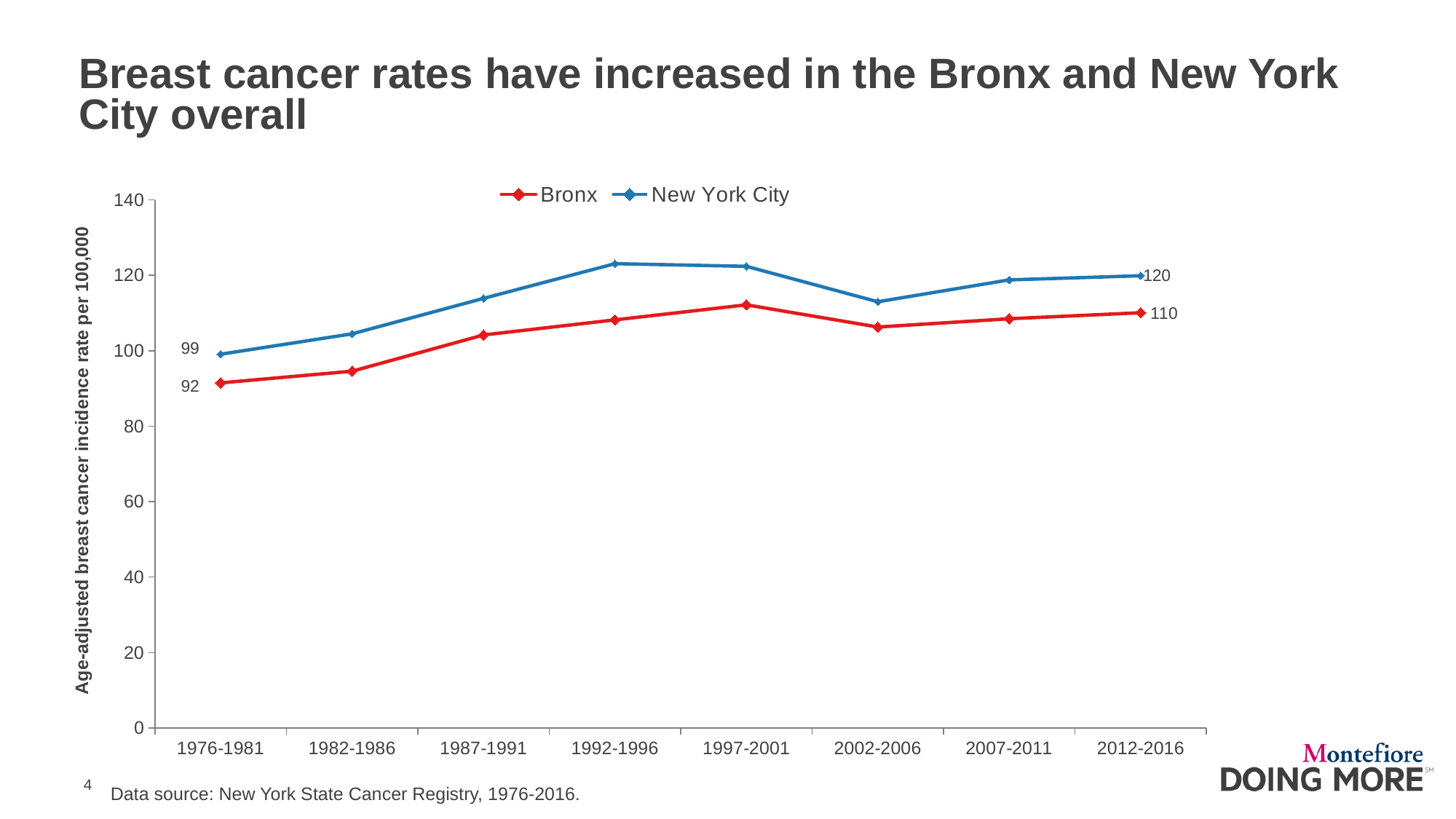
How many time periods are shown on the x axis? 8 Is the New York City value for 1992-1996 greater or less than 120? greater What is the New York City breast cancer incidence rate for 2012-2016? 120 What is the Bronx breast cancer incidence rate for 1976-1981? 92 How many series does the legend list? 2 What is the difference between the New York City and Bronx rates in 2012-2016? 10 What kind of chart is shown on the slide? Line chart What is the Bronx breast cancer incidence rate for 2012-2016? 110 What is the New York City breast cancer incidence rate for 1976-1981? 99 In 1997-2001, which series has the higher rate, Bronx or New York City? New York City Which series is drawn in red? Bronx By how much did the Bronx rate increase from 1976-1981 to 2012-2016? 18